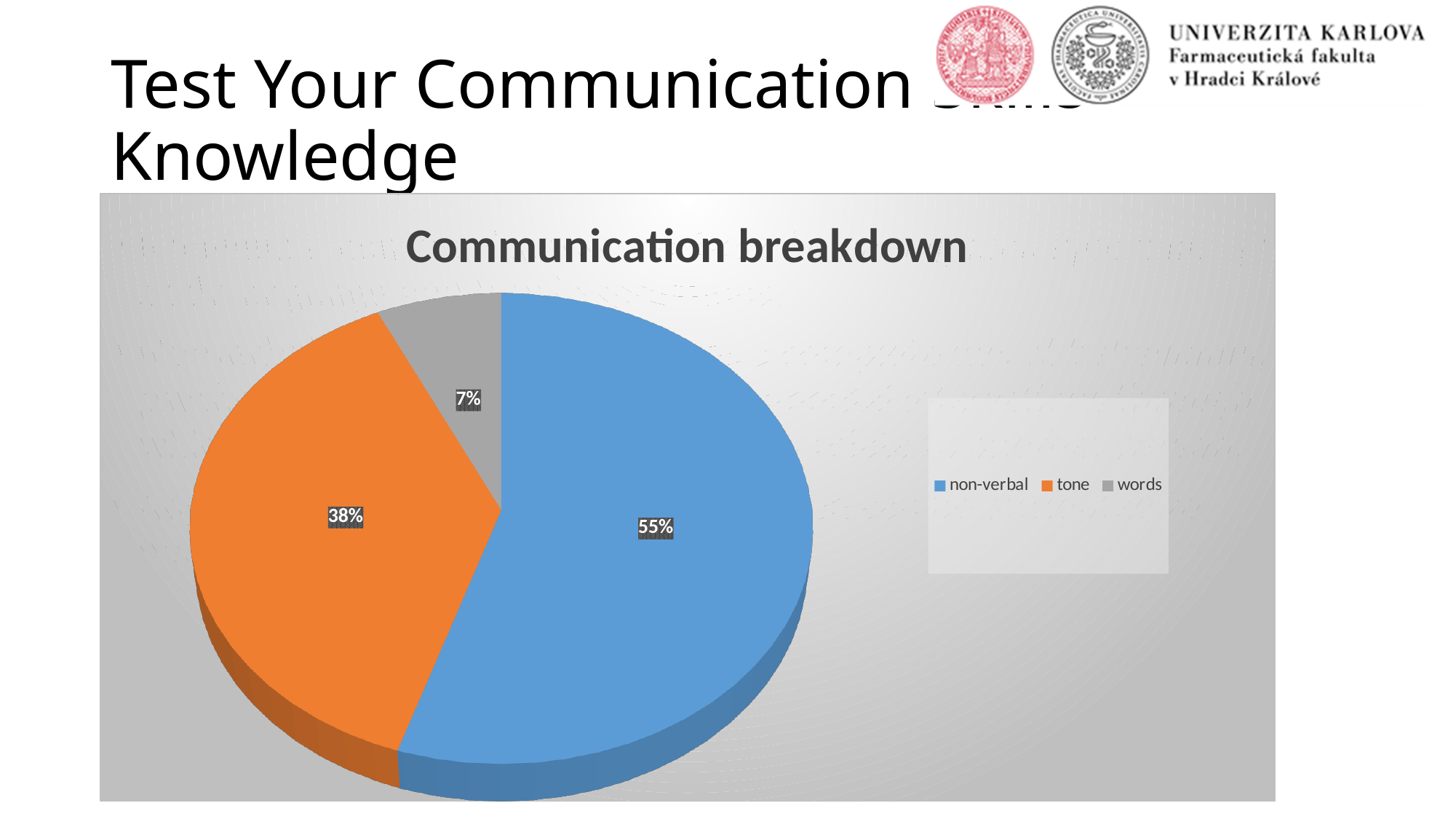
What kind of chart is shown on the slide? pie chart What is the difference between the non-verbal share and the tone share? 17% What is the difference between the tone share and the words share? 31% How many categories does the pie chart show? 3 What share of the pie does tone take? 38% Which is larger, the share for tone or the share for words? tone What share of the pie does words take? 7% What is the title of the chart? Communication breakdown What share of the pie does non-verbal take? 55% Which category has the largest slice of the pie? non-verbal Which colour represents tone in the chart? orange Which category has the smallest slice of the pie? words